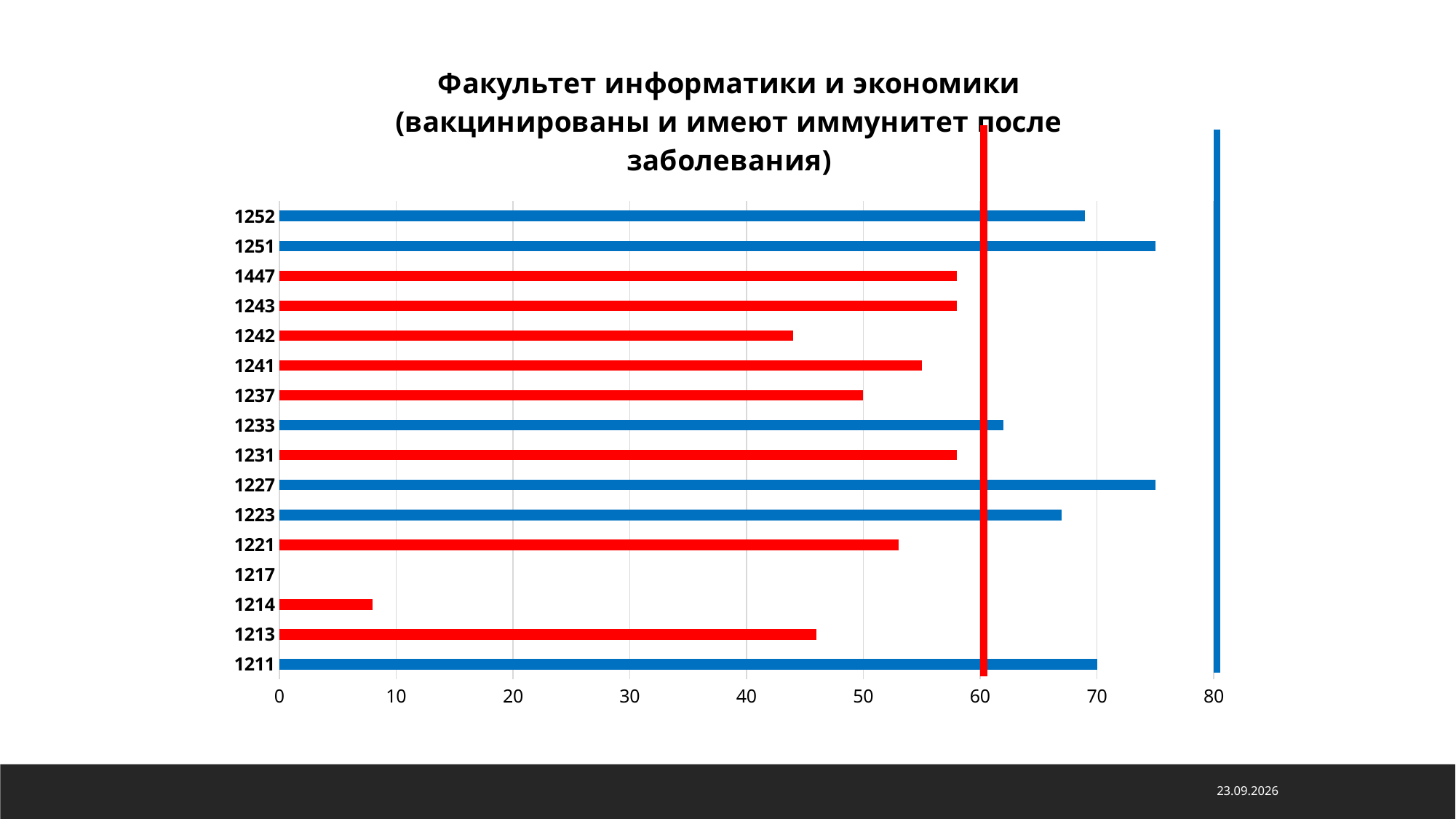
At what value on the horizontal axis is the red vertical line drawn? 60 Is the value for group 1214 greater or less than 10? less Is the value for group 1211 greater or less than 60? greater Is the value for group 1213 greater or less than 50? less Which group has the larger value, 1251 or 1447? 1251 Which group has the larger value, 1252 or 1242? 1252 What kind of chart is shown on the slide? bar chart Which group has no bar shown on the chart? 1217 How many group categories are listed on the vertical axis of the chart? 16 Which group has the larger value, 1214 or 1213? 1213